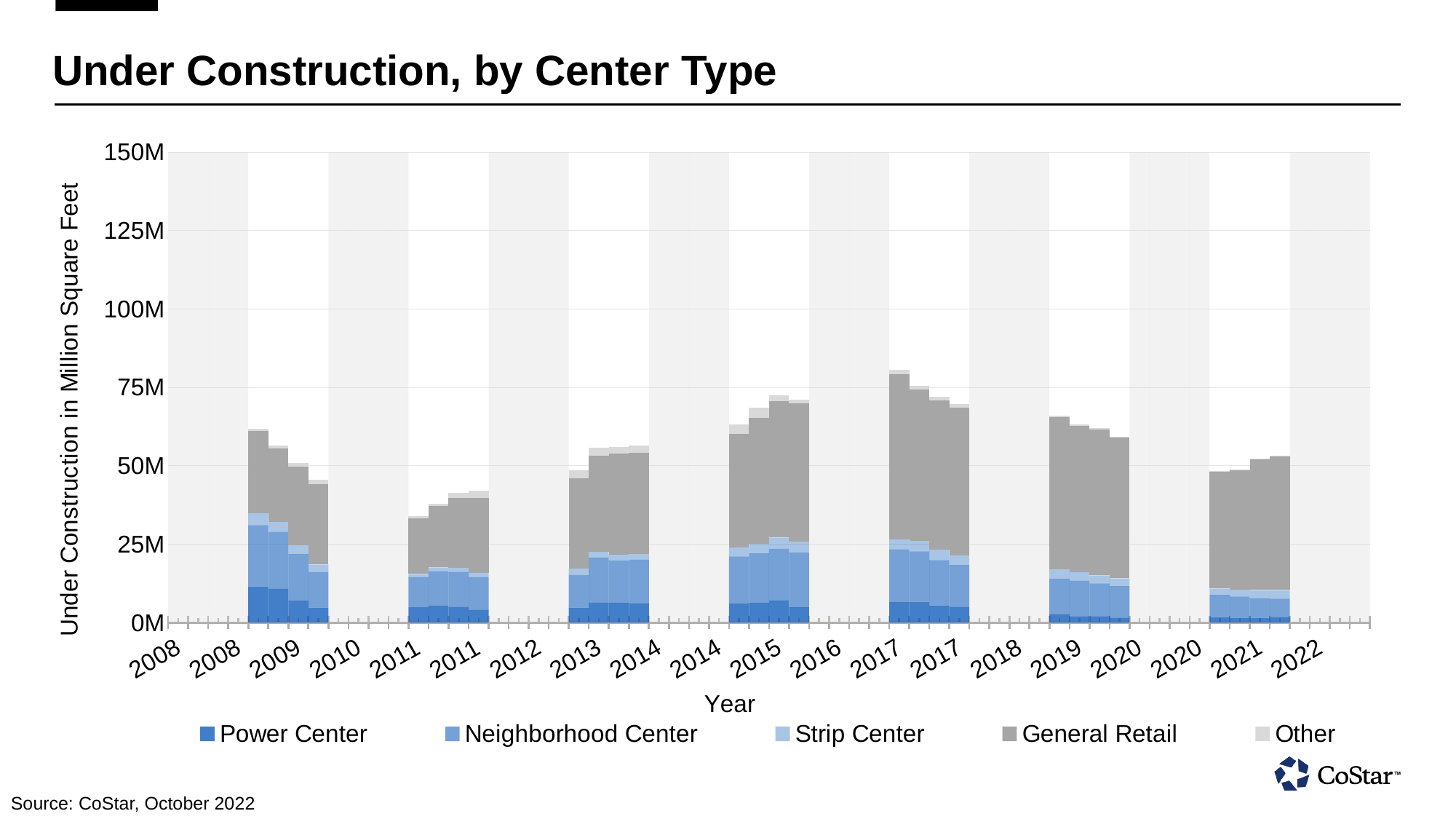
Near which year label does the tallest stacked bar appear? 2017 What kind of chart is shown on the slide? Stacked bar chart Which is taller: the tallest bar near the 2017 label or the tallest bar near the 2021 label? 2017 Near which year label does the shortest stacked bar appear? 2011 What is the label of the vertical axis? Under Construction in Million Square Feet Is the tallest stacked bar on the chart greater or less than 75M? greater Are the stacked bars in the group above the 2019 label greater or less than 75M? less Within the group of bars above the 2017 label, do the bar totals rise or fall from left to right? fall What is the title of the chart? Under Construction, by Center Type Are the stacked bars in the group above the 2011 label greater or less than 50M? less How many series does the legend list? 5